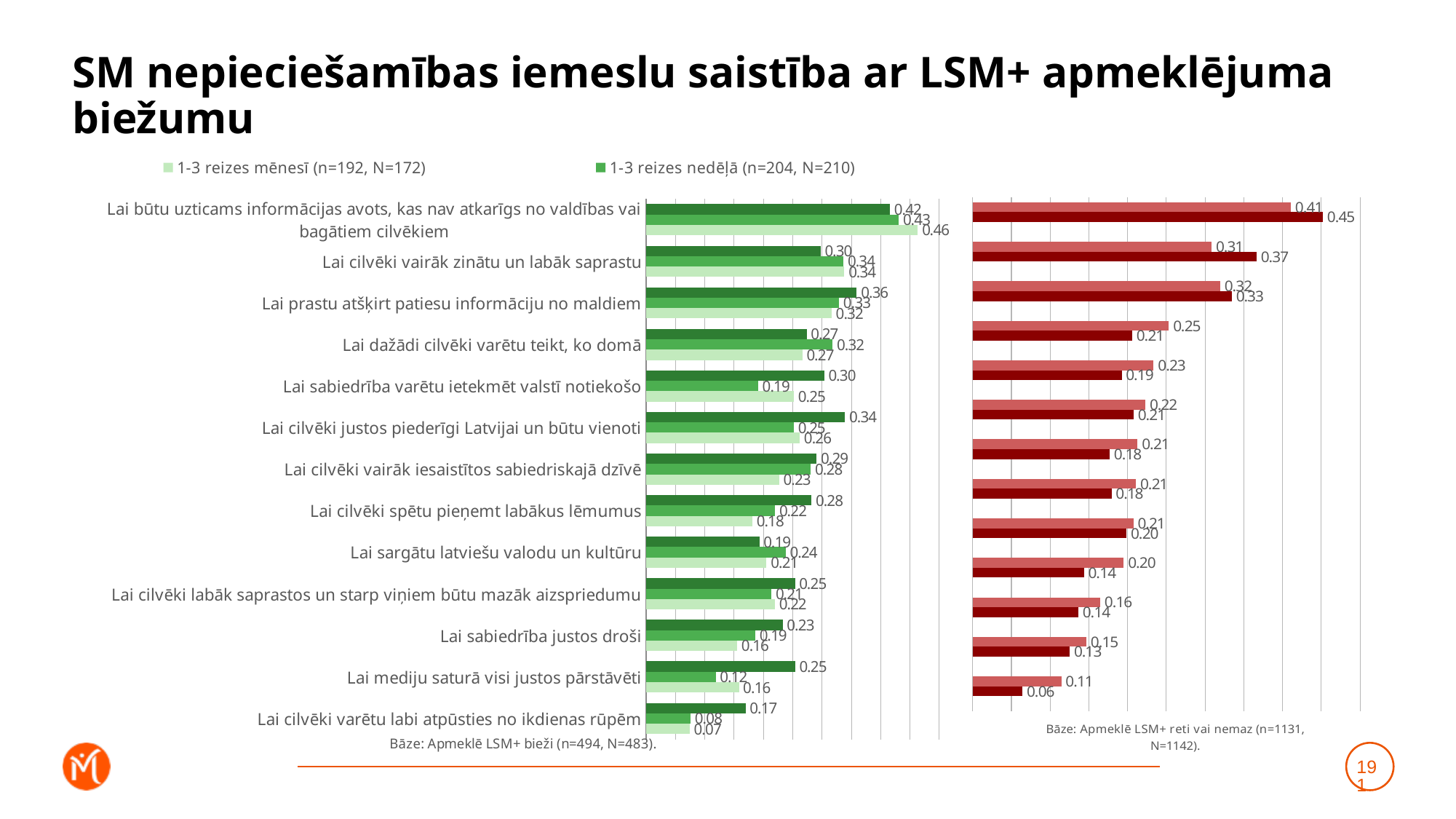
In the green chart on the left, what is the value of the '1-3 reizes nedēļā' series for 'Lai cilvēki justos piederīgi Latvijai un būtu vienoti'? 0.25 How many categories are shown in the green chart on the left? 13 In the green chart on the left, what is the difference between the '1-3 reizes nedēļā' value and the '1-3 reizes mēnesī' value for 'Lai mediju saturā visi justos pārstāvēti'? 0.04 In the green chart on the left, what is the value of the '1-3 reizes mēnesī' series for 'Lai būtu uzticams informācijas avots, kas nav atkarīgs no valdības vai bagātiem cilvēkiem'? 0.46 In the green chart on the left, which category has the lowest value for the '1-3 reizes mēnesī' series? Lai cilvēki varētu labi atpūsties no ikdienas rūpēm In the red chart on the right, for 'Lai dažādi cilvēki varētu teikt, ko domā', which bar is larger: the light red or the dark red? light red What kind of chart is the green chart on the left? bar chart In the red chart on the right, which category has the highest dark red value? Lai būtu uzticams informācijas avots, kas nav atkarīgs no valdības vai bagātiem cilvēkiem In the red chart on the right, what is the value of the light red bar for 'Lai mediju saturā visi justos pārstāvēti'? 0.15 In the red chart on the right, what is the difference between the light red and dark red values for 'Lai cilvēki varētu labi atpūsties no ikdienas rūpēm'? 0.05 In the red chart on the right, what is the value of the dark red bar for 'Lai cilvēki vairāk zinātu un labāk saprastu'? 0.37 In the green chart on the left, for 'Lai sabiedrība varētu ietekmēt valstī notiekošo', which is larger: the '1-3 reizes nedēļā' value or the '1-3 reizes mēnesī' value? 1-3 reizes mēnesī